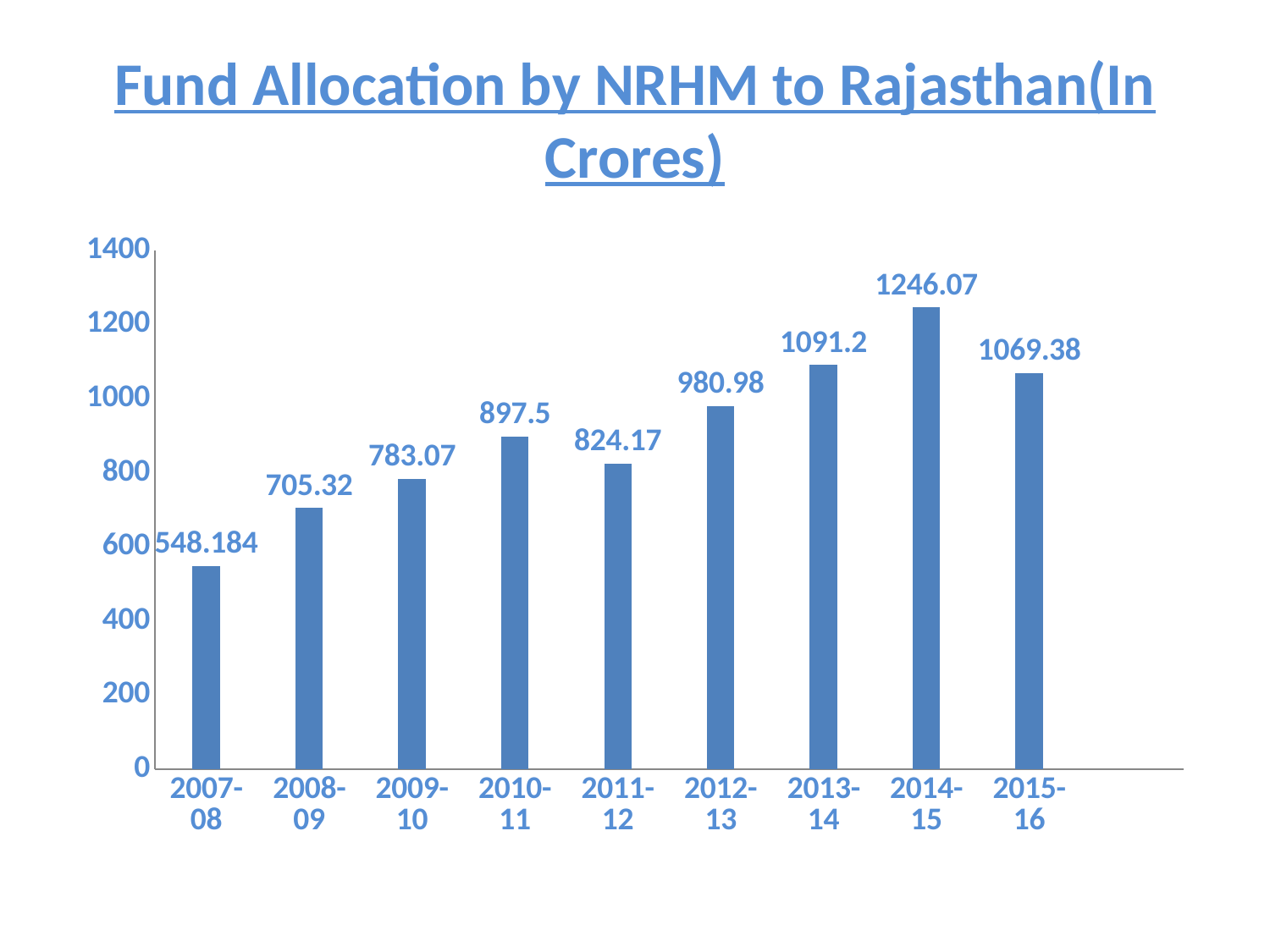
How many years are shown on the chart? 9 What kind of chart is shown on the slide? bar chart What is the fund allocation for 2015-16? 1069.38 What is the title of the chart? Fund Allocation by NRHM to Rajasthan(In Crores) What is the fund allocation for 2007-08? 548.184 What is the difference between the fund allocation for 2010-11 and 2011-12? 73.33 Which year has the highest fund allocation? 2014-15 Is the fund allocation for 2009-10 greater or less than 800? less Which year has the lowest fund allocation? 2007-08 What is the fund allocation for 2012-13? 980.98 What is the difference between the fund allocation for 2014-15 and 2015-16? 176.69 Which is larger, the fund allocation for 2013-14 or 2015-16? 2013-14